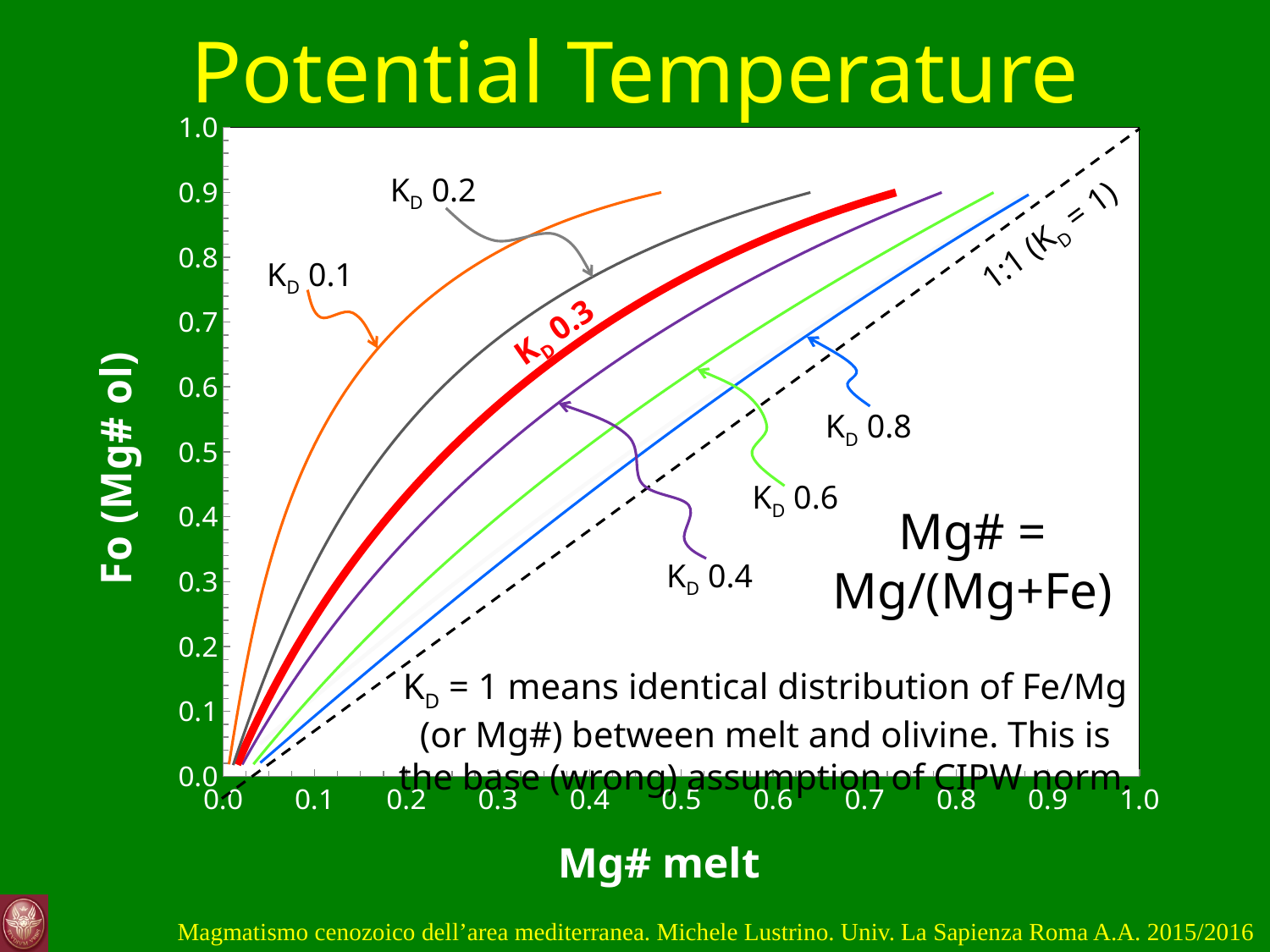
At Mg# melt = 0.4, which curve has the higher Fo value, K_D 0.1 or K_D 0.8? K_D 0.1 Do the curves rise or fall as Mg# melt increases? rise At Mg# melt = 0.2, is the value of the K_D 0.8 curve greater or less than 0.3? less Which line on the chart is drawn dashed? 1:1 (K_D = 1) How many K_D curves are plotted, not counting the dashed 1:1 line? 6 What is the label of the x axis? Mg# melt At Mg# melt = 0.4, is the value of the K_D 0.1 curve greater or less than 0.8? greater What is the label of the y axis? Fo (Mg# ol) Which curve lies highest on the chart for any given Mg# melt value? K_D 0.1 At Mg# melt = 0.6, which curve has the lower Fo value, K_D 0.2 or K_D 0.6? K_D 0.6 What kind of chart is shown on the slide? line chart At Mg# melt = 0.5, is the value of the K_D 0.3 curve greater or less than 0.7? greater